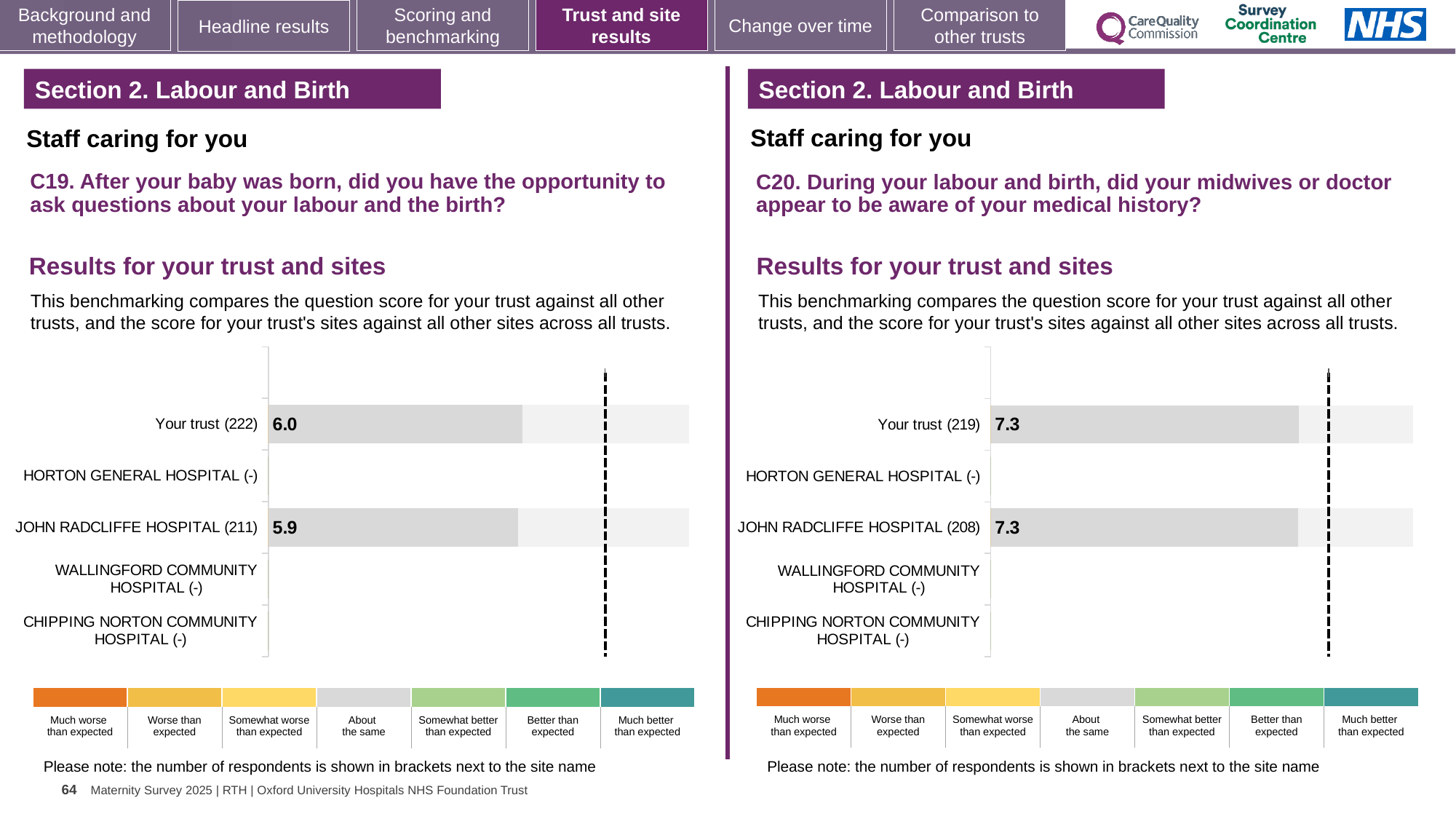
What is the label of the leftmost colour band in the legend below the C20 chart (right)? Much worse than expected On the C19 chart (left), what is the difference between the score for Your trust and the score for JOHN RADCLIFFE HOSPITAL? 0.1 On the C20 chart (right), what is the score for Your trust? 7.3 How many site or trust categories are listed on the C19 chart (left)? 5 What kind of chart is used on the C20 chart (right)? Bar chart On the C20 chart (right), what is the score for JOHN RADCLIFFE HOSPITAL? 7.3 On the C19 chart (left), what is the score for JOHN RADCLIFFE HOSPITAL? 5.9 On the C19 chart (left), which site has a score of 5.9? JOHN RADCLIFFE HOSPITAL On the C20 chart (right), what is the difference between the score for Your trust and the score for JOHN RADCLIFFE HOSPITAL? 0.0 On the C19 chart (left), what is the score for Your trust? 6.0 On the C20 chart (right), how many respondents are shown in brackets for JOHN RADCLIFFE HOSPITAL? 208 On the C19 chart (left), how many respondents are shown in brackets for Your trust? 222